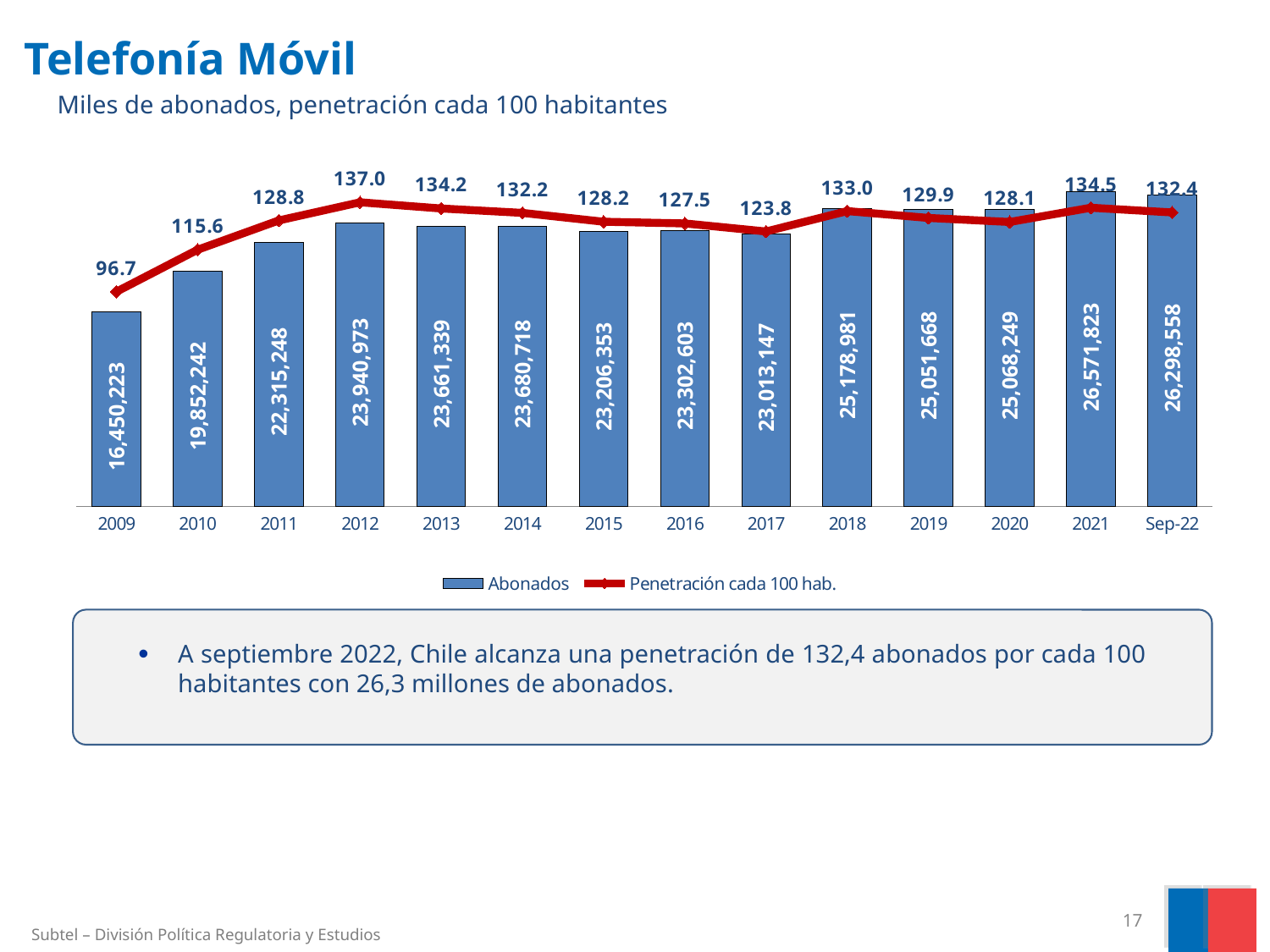
Which year has the lowest Penetración cada 100 hab. value? 2009 In which year does the Penetración cada 100 hab. line reach its highest value? 2012 By how much did Penetración cada 100 hab. increase from 2009 to 2012? 40.3 What is the number of Abonados shown for Sep-22? 26,298,558 What is the number of Abonados shown for 2012? 23,940,973 Which period has the highest number of Abonados? 2021 Does the Penetración cada 100 hab. line rise or fall from 2012 to 2017? fall How many periods are shown on the x axis? 14 How many series does the legend list? 2 Which has more Abonados, 2018 or 2019? 2018 What is the difference in Abonados between 2021 and Sep-22? 273,265 What is the Penetración cada 100 hab. value for 2017? 123.8